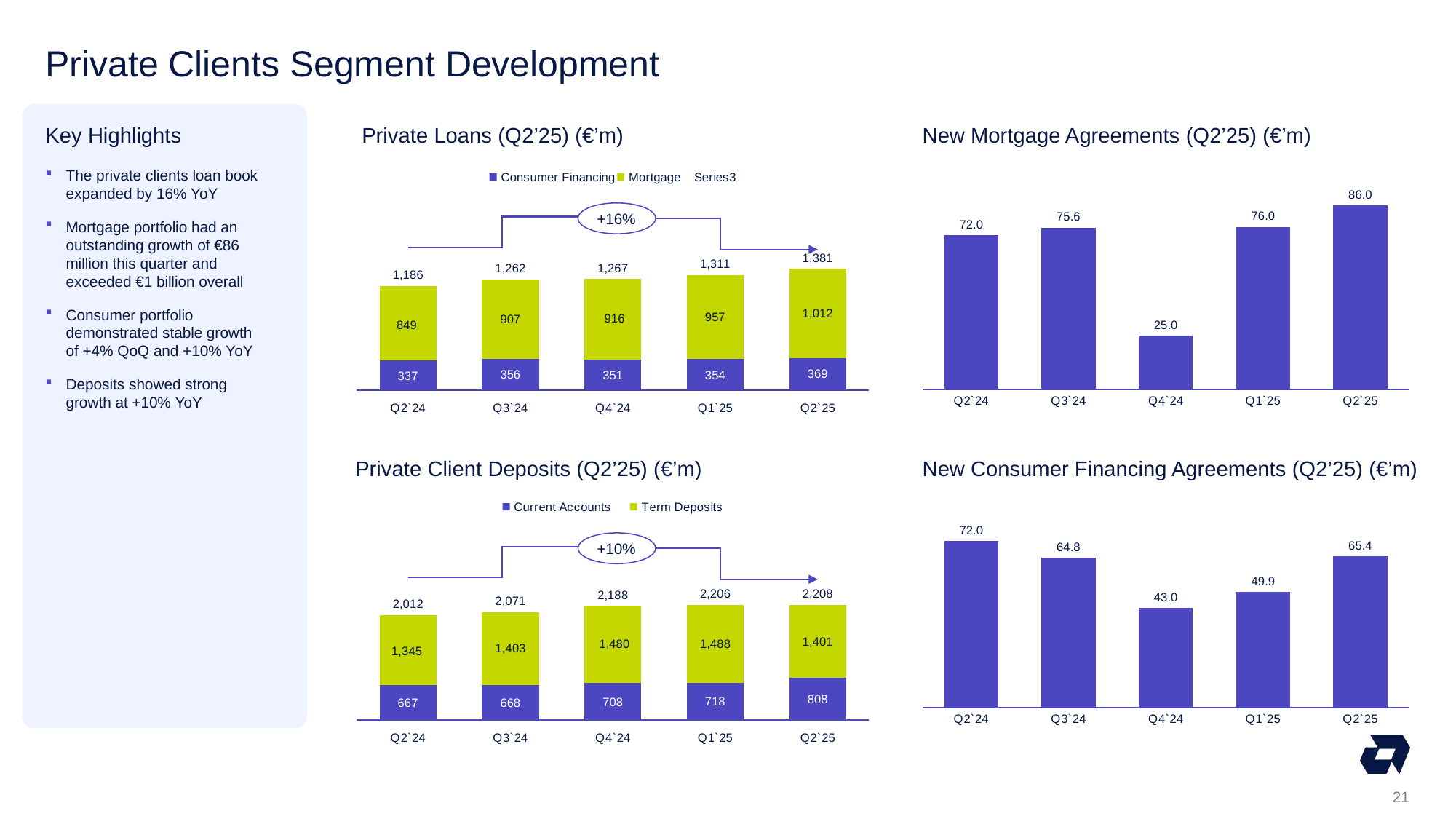
What type of chart is the New Consumer Financing Agreements chart? Bar chart In the New Mortgage Agreements chart, which quarter has the lowest value? Q4`24 In the New Consumer Financing Agreements chart, which is larger, Q3`24 or Q2`25? Q2`25 In the New Mortgage Agreements chart, what is the value for Q2`25? 86.0 How many quarters are shown in the New Consumer Financing Agreements chart? 5 In the New Mortgage Agreements chart, what is the difference between Q2`25 and Q2`24? 14.0 In the Private Client Deposits chart, what is the Current Accounts value for Q2`25? 808 In the Private Loans chart, what is the Mortgage value for Q2`25? 1,012 In the Private Loans chart, what is the total of the stacked bar for Q3`24? 1,262 In the Private Loans chart, what is the Consumer Financing value for Q4`24? 351 In the Private Client Deposits chart, which quarter has the highest Term Deposits value? Q1`25 How many series does the legend of the Private Client Deposits chart list? 2